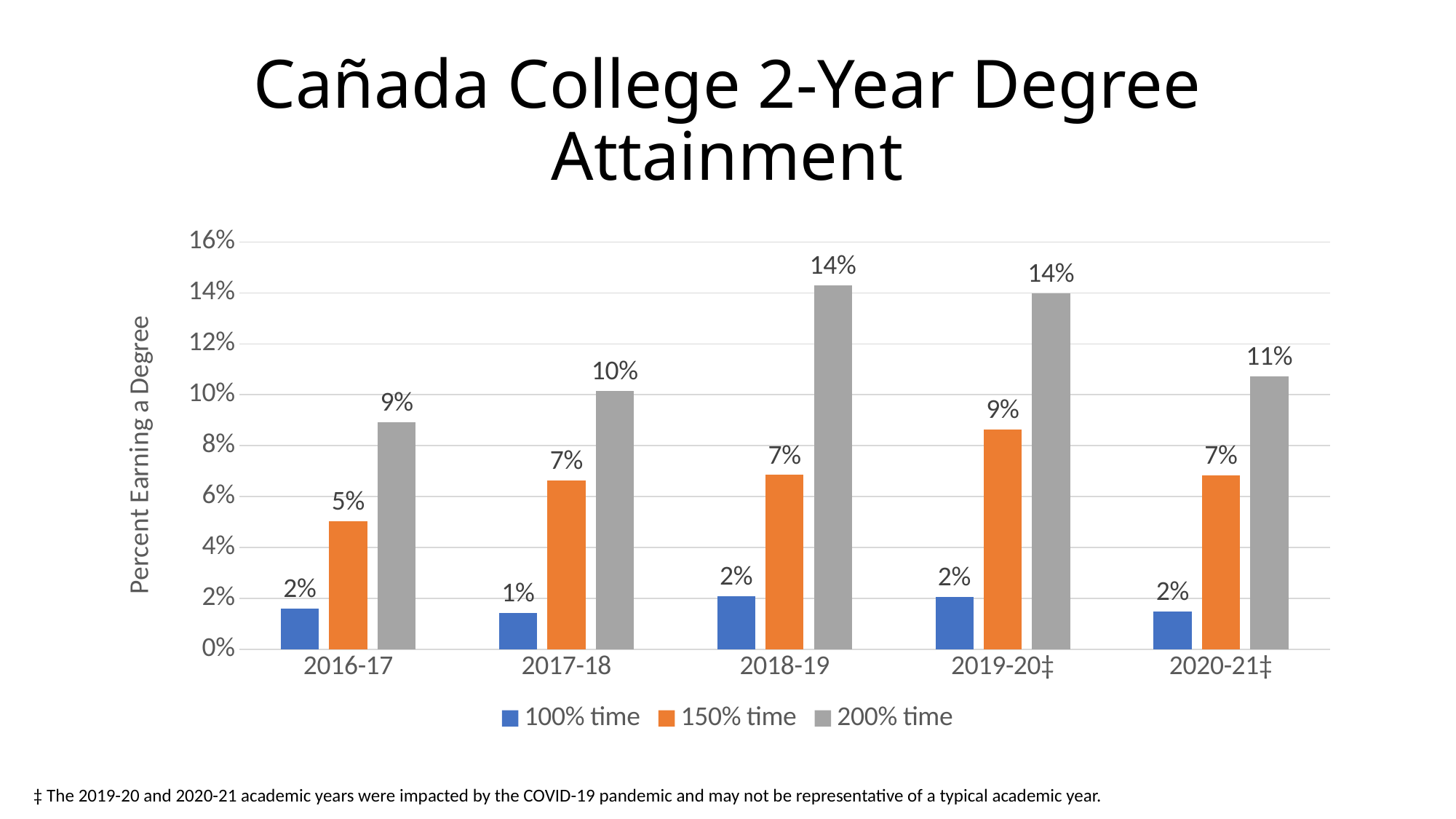
How many academic years are shown on the x axis? 5 Which year has the lowest value for 200% time? 2016-17 What is the value for 150% time in 2019-20‡? 9% Which year has the highest value for 150% time? 2019-20‡ What kind of chart is shown on the slide? bar chart What is the value for 100% time in 2017-18? 1% What is the value for 200% time in 2018-19? 14% Which is larger in 2020-21‡: the 150% time value or the 200% time value? 200% time Is the value for 200% time in 2018-19 greater or less than 12%? greater What is the label on the y axis? Percent Earning a Degree What is the difference between the 200% time and 100% time values in 2016-17? 7 percentage points How many series does the legend list? 3